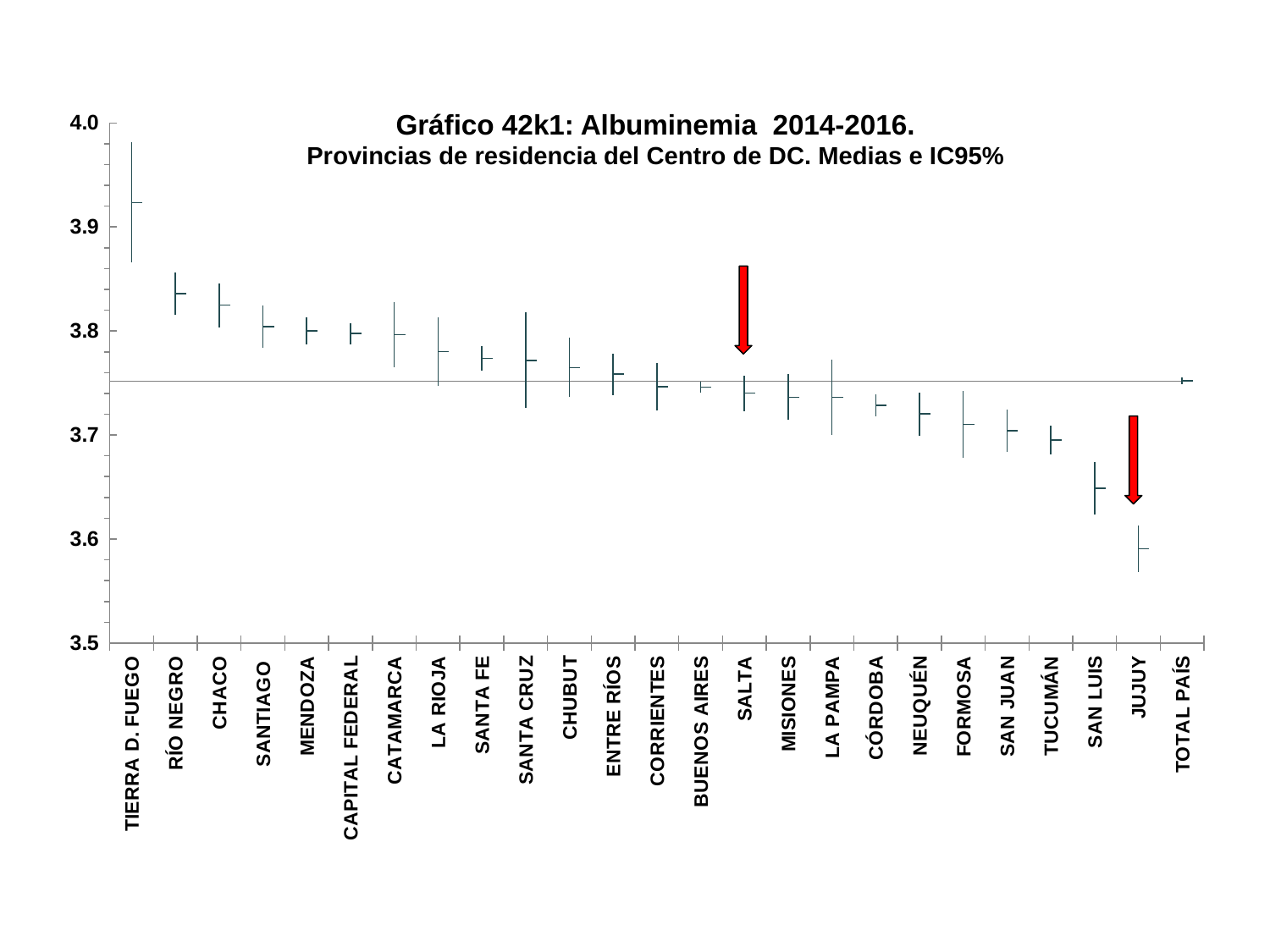
Is the mean value for SAN LUIS greater or less than 3.7? less Is the mean value for JUJUY greater or less than 3.6? less Which category has the highest mean albuminemia? TIERRA D. FUEGO Which category has the lowest mean albuminemia? JUJUY Do the mean values generally rise or fall from left to right along the x axis? fall Is the mean value for TIERRA D. FUEGO greater or less than 3.9? greater Which has a higher mean value, CHACO or SAN JUAN? CHACO What is the title of the chart? Gráfico 42k1: Albuminemia 2014-2016. How many categories are shown along the x axis? 25 What kind of chart is this? A mean with confidence interval (error bar) chart Which two categories are marked with red arrows? SALTA and JUJUY